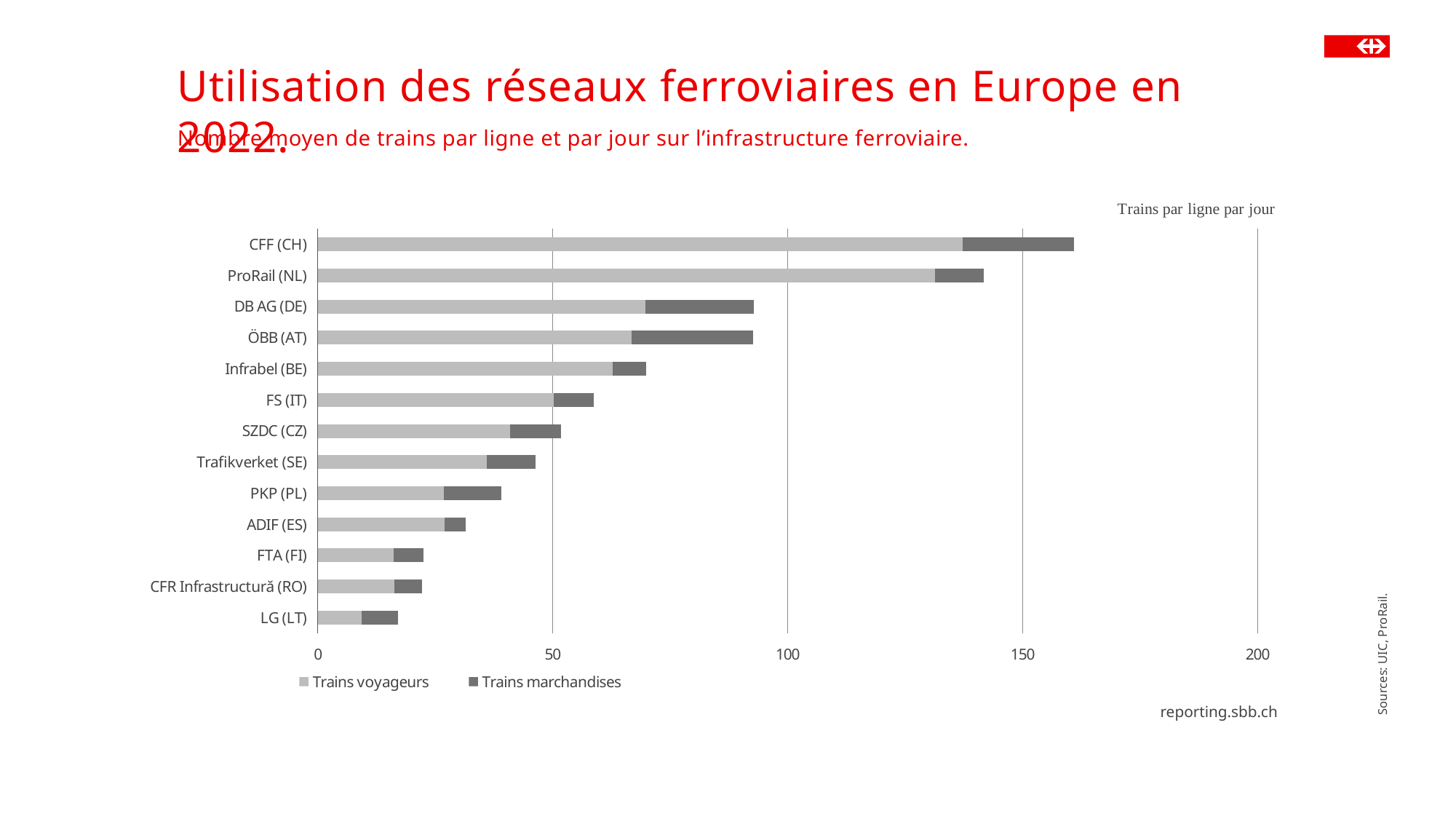
What kind of chart is shown on the slide? Stacked horizontal bar chart How many series does the legend list? 2 Is the total value for CFF (CH) greater or less than 150? greater How many rail infrastructure managers (categories) are plotted in the chart? 13 Is the total value for Infrabel (BE) greater or less than 50? greater What are the two series named in the legend? Trains voyageurs and Trains marchandises Is the total value for DB AG (DE) greater or less than 100? less Which category has the highest total number of trains per line per day? CFF (CH) Which has a larger total value, Infrabel (BE) or FS (IT)? Infrabel (BE) Which category has the lowest total number of trains per line per day? LG (LT)